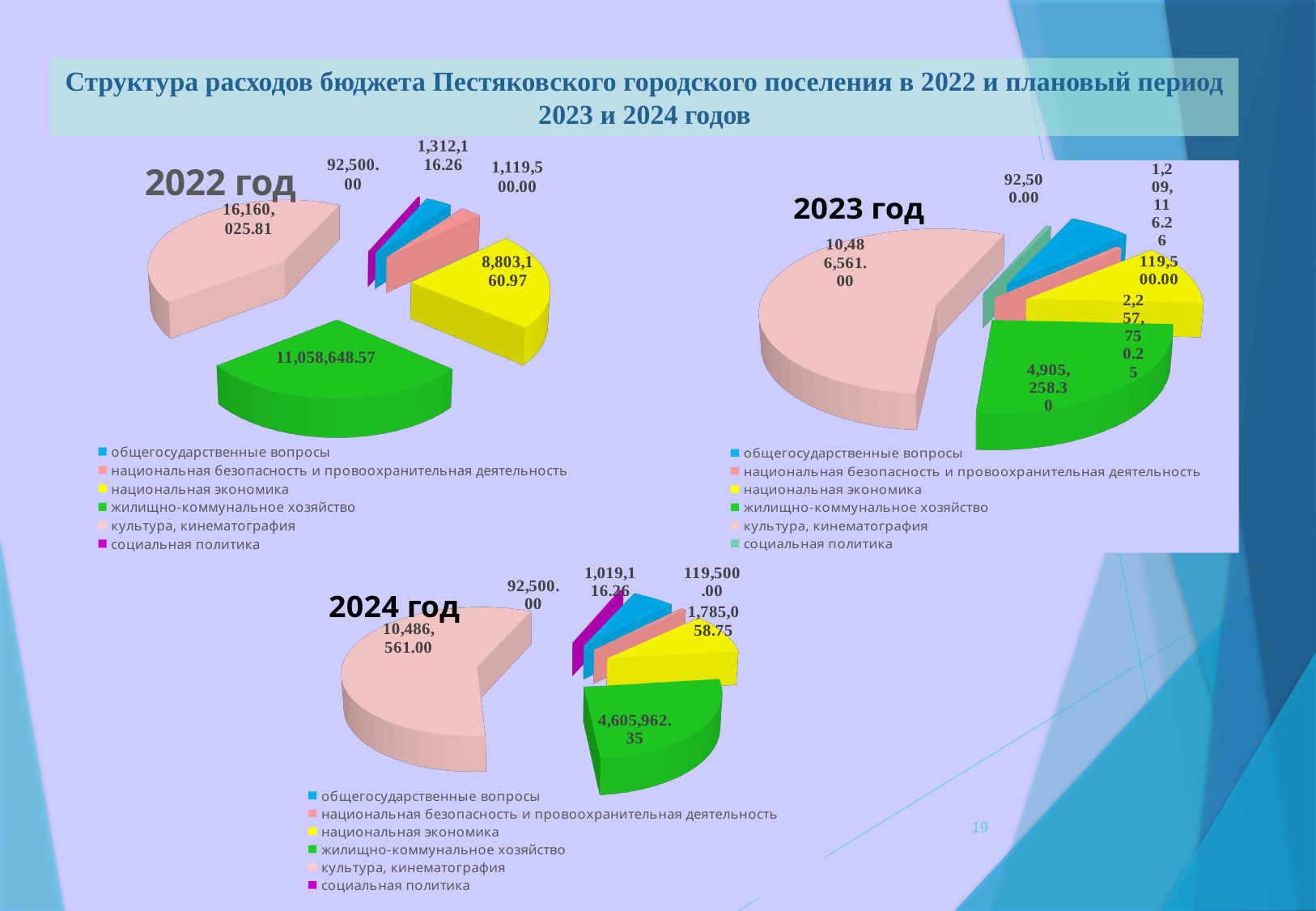
In the 2024 год chart, what is the value for жилищно-коммунальное хозяйство? 4,605,962.35 What is the difference between the value for жилищно-коммунальное хозяйство in the 2023 год chart and in the 2024 год chart? 299,295.95 In the 2023 год chart, what is the value for культура, кинематография? 10,486,561.00 In the 2023 год chart, what is the value for жилищно-коммунальное хозяйство? 4,905,258.30 In the 2024 год chart, which is larger: культура, кинематография or жилищно-коммунальное хозяйство? культура, кинематография What kind of chart is used for the 2022 год chart? pie chart In the 2022 год chart, what is the value for национальная экономика? 8,803,160.97 In the 2024 год chart, what is the value for национальная экономика? 1,785,058.75 In the 2022 год chart, which category has the smallest slice? социальная политика How many entries does the legend of the 2022 год chart list? 6 In the 2022 год chart, which category has the largest slice? культура, кинематография In the 2022 год chart, what is the value for жилищно-коммунальное хозяйство? 11,058,648.57